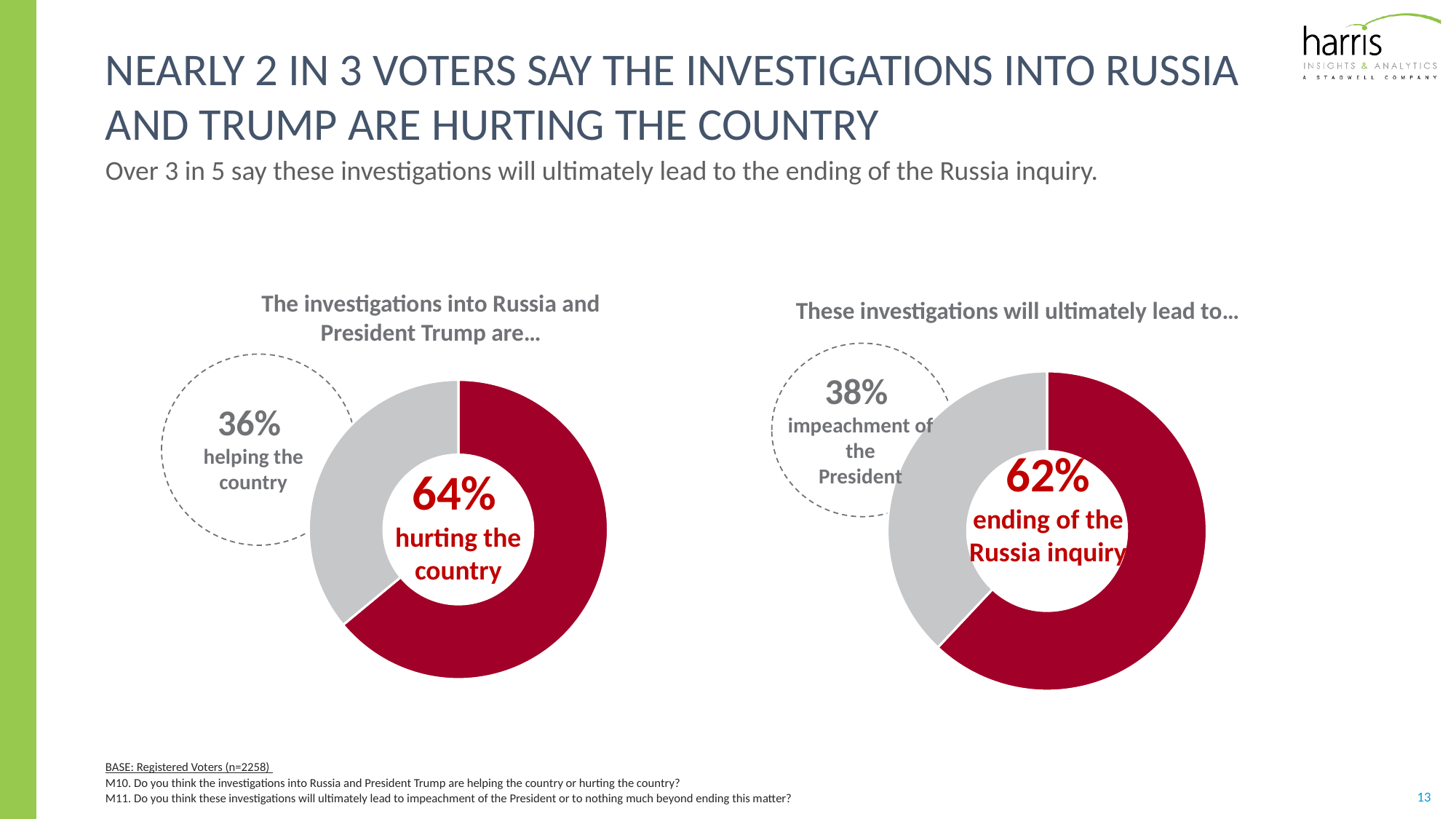
In the left chart, what share of the donut does the 'hurting the country' segment represent? 64% What type of chart is used on the left side of the slide? Donut (pie) chart In the left chart, which response has the larger share: 'hurting the country' or 'helping the country'? hurting the country In the left chart, what is the difference in percentage points between 'hurting the country' and 'helping the country'? 28 How many segments does the chart titled 'These investigations will ultimately lead to...' have? 2 In the right chart, what is the difference in percentage points between 'ending of the Russia inquiry' and 'impeachment of the President'? 24 In the chart titled 'The investigations into Russia and President Trump are...', what percentage say the investigations are helping the country? 36% In the right chart, which response has the smaller share: 'impeachment of the President' or 'ending of the Russia inquiry'? impeachment of the President In the chart titled 'The investigations into Russia and President Trump are...', what percentage say the investigations are hurting the country? 64% In the right chart, what colour is the 'ending of the Russia inquiry' segment? Red In the chart titled 'These investigations will ultimately lead to...', what percentage say the investigations will lead to ending of the Russia inquiry? 62% In the chart titled 'These investigations will ultimately lead to...', what percentage say the investigations will lead to impeachment of the President? 38%